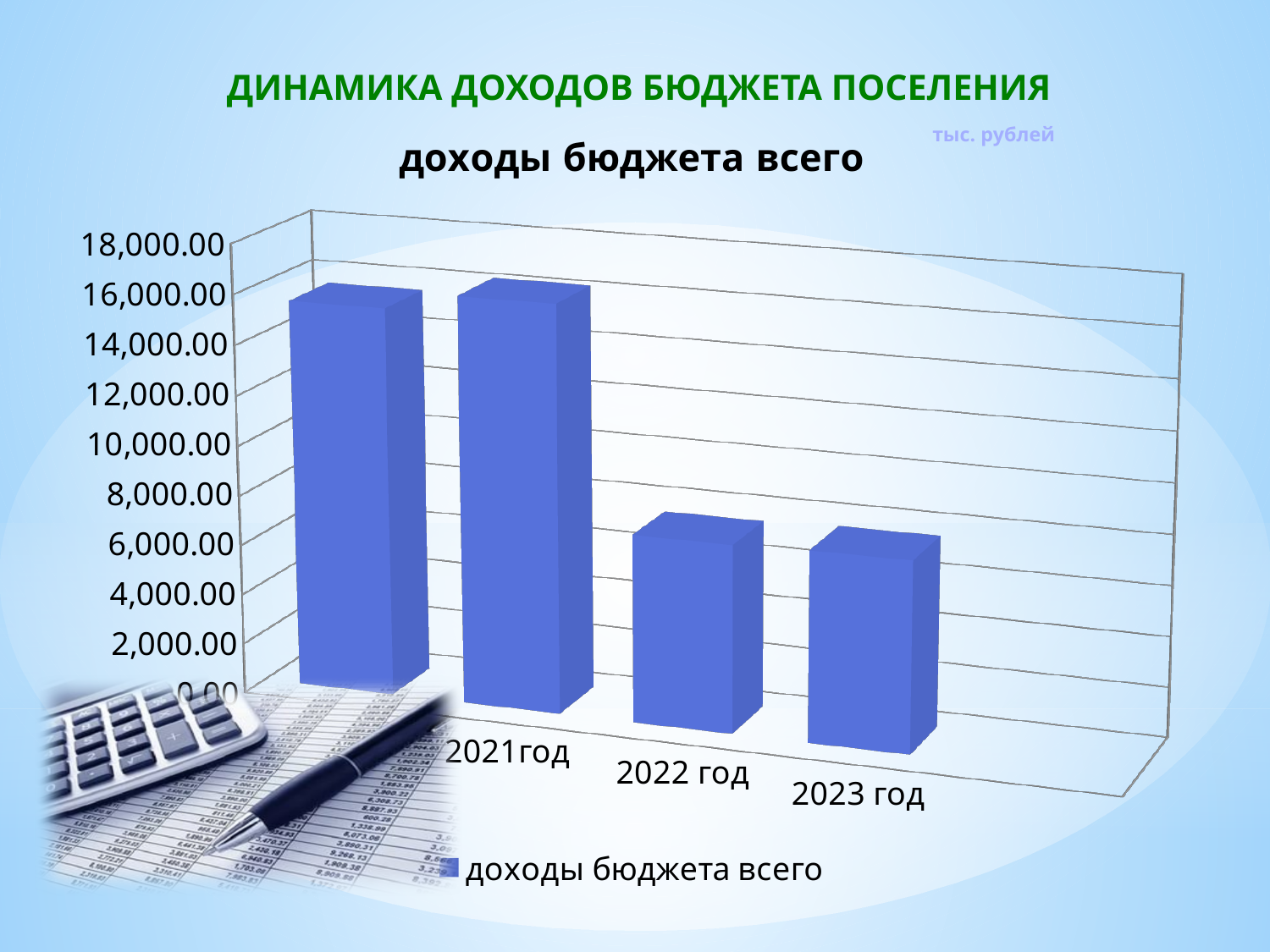
How many series does the legend list? 1 Is the value for 2022 год greater or less than 8,000.00? less What is the title of the chart? доходы бюджета всего How many bars are plotted in the chart? 4 Is the value for 2023 год greater or less than 8,000.00? less Do the values rise or fall from 2021 год to 2023 год? fall Is the value for 2022 год greater or less than 4,000.00? greater Which is larger, the value for 2021 год or the value for 2023 год? 2021 год What unit is indicated for the chart values? тыс. рублей Which is larger, the value for 2021 год or the value for 2022 год? 2021 год What kind of chart is shown on the slide? bar chart